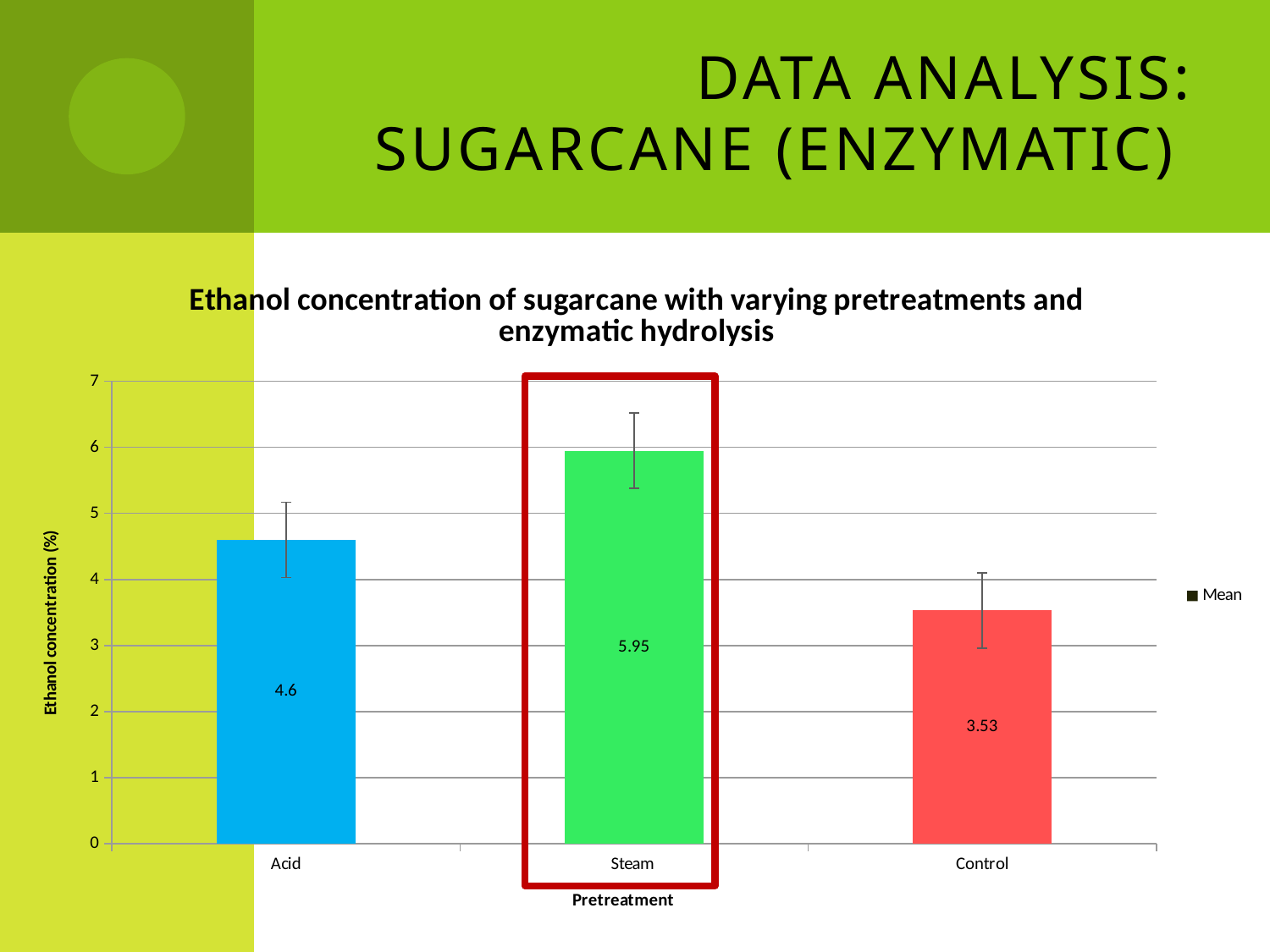
What is the difference in ethanol concentration between Acid and Control? 1.07 What is the ethanol concentration for the Acid pretreatment? 4.6 How many pretreatment categories are shown on the x axis? 3 What series name does the legend list? Mean What kind of chart is shown on the slide? Bar chart What is the ethanol concentration for the Control? 3.53 Which has a higher ethanol concentration, Acid or Control? Acid What is the ethanol concentration for the Steam pretreatment? 5.95 Which pretreatment has the highest ethanol concentration? Steam Is the value for Steam greater or less than 5? greater What is the difference in ethanol concentration between Steam and Acid? 1.35 Which pretreatment has the lowest ethanol concentration? Control